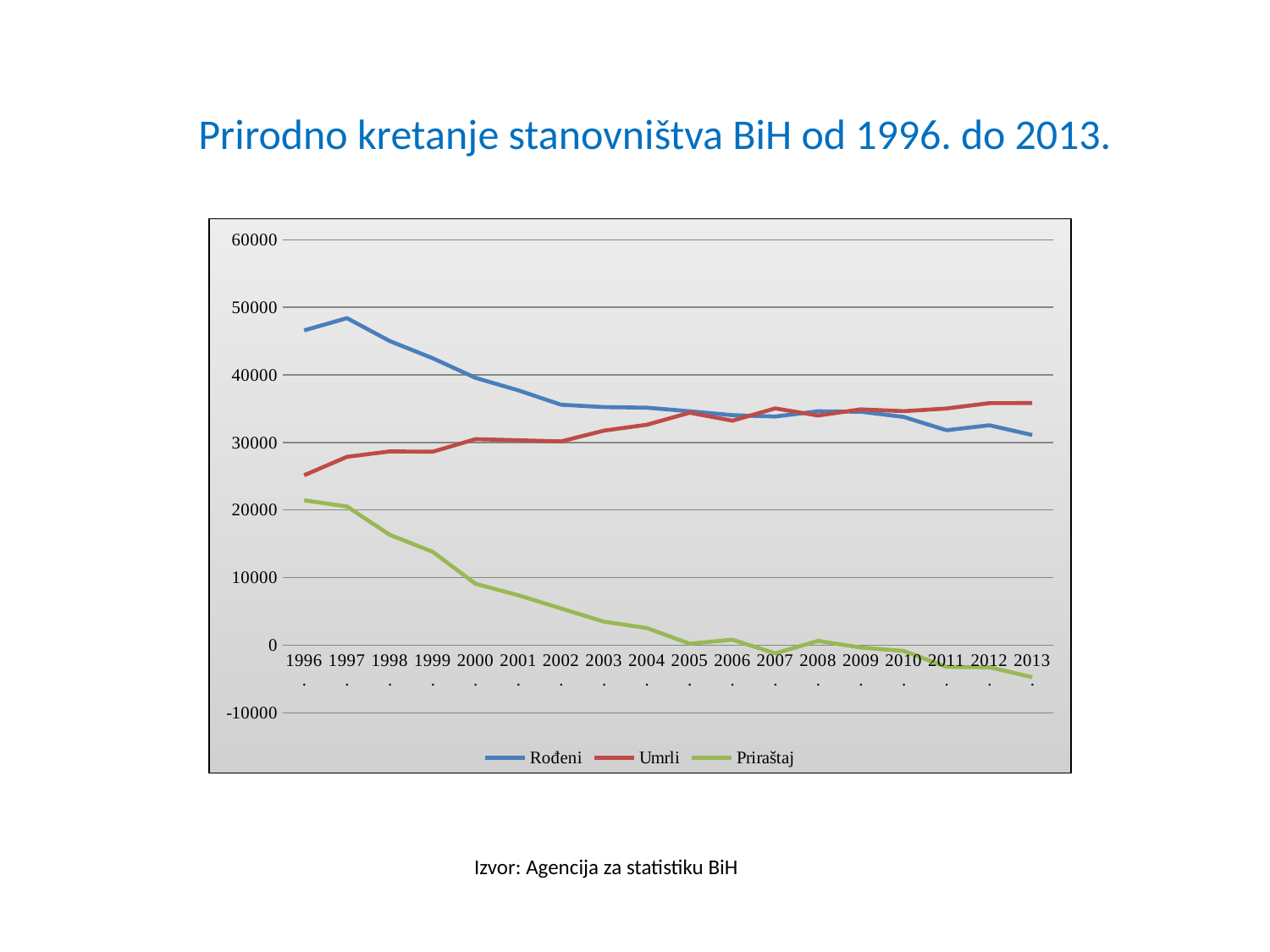
Is the value for Umrli in 1996 greater or less than 30000? less What is the title of the chart? Prirodno kretanje stanovništva BiH od 1996. do 2013. In which year does the Rođeni series reach its highest value? 1997 Is the value for Rođeni in 1997 greater or less than 40000? greater What kind of chart is shown on the slide? line chart Does the Rođeni series rise or fall overall from 1996 to 2013? fall In which year does the Priraštaj series reach its lowest value? 2013 Does the Umrli series rise or fall overall from 1996 to 2013? rise In 1996, which is larger: Rođeni or Umrli? Rođeni How many years are plotted along the x axis? 18 Is the value for Priraštaj in 2013 greater or less than 0? less How many series does the legend list? 3